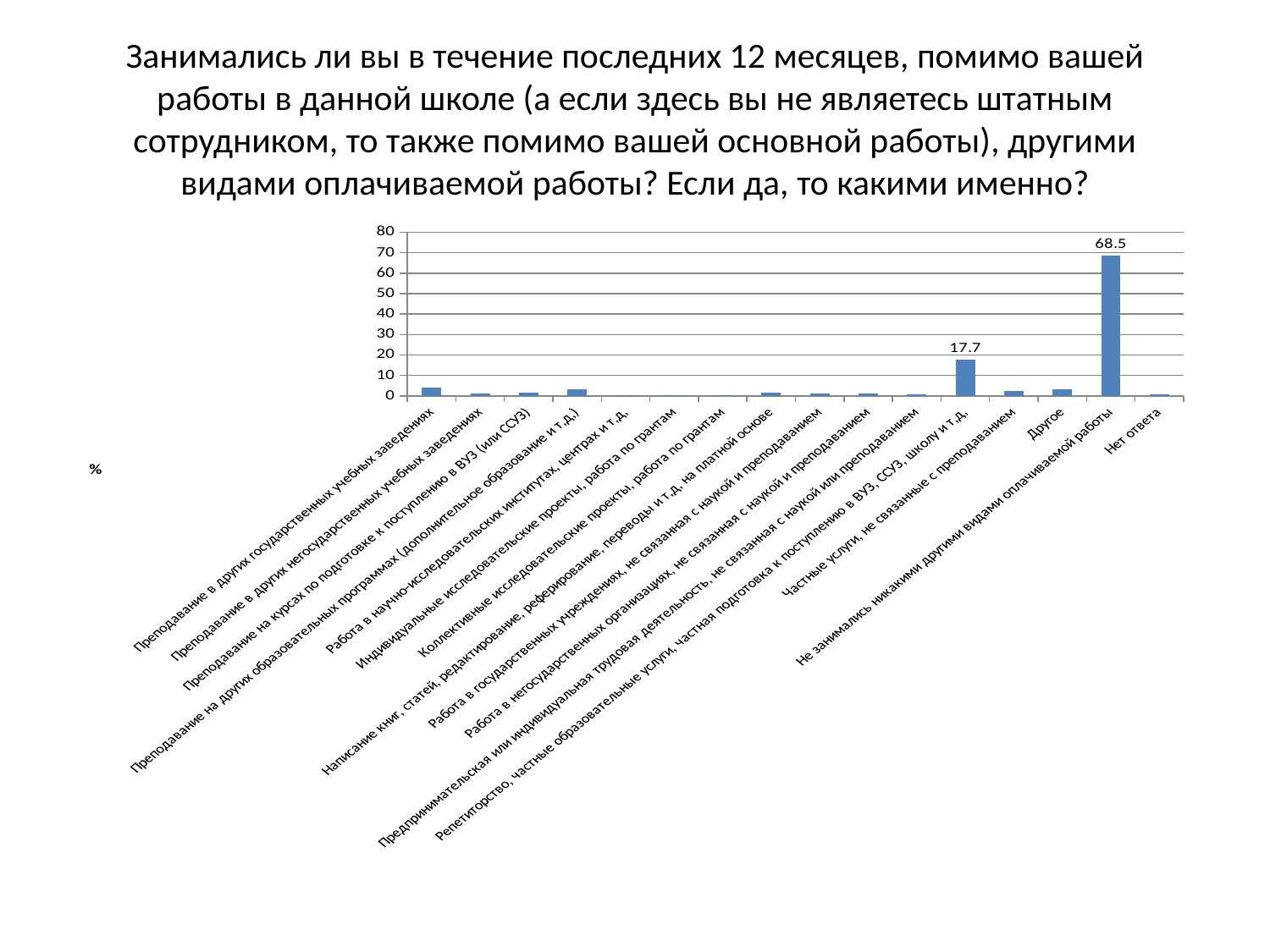
Which is larger: the value for "Репетиторство, частные образовательные услуги, частная подготовка к поступлению в ВУЗ, ССУЗ, школу и т.д." or the value for "Другое"? Репетиторство, частные образовательные услуги, частная подготовка к поступлению в ВУЗ, ССУЗ, школу и т.д. How many categories are shown on the x axis of the chart? 16 What kind of chart is shown on the slide? Bar chart Is the value for "Репетиторство, частные образовательные услуги, частная подготовка к поступлению в ВУЗ, ССУЗ, школу и т.д." greater or less than 20? less What value is shown for "Репетиторство, частные образовательные услуги, частная подготовка к поступлению в ВУЗ, ССУЗ, школу и т.д."? 17.7 Which category has the highest value? Не занимались никакими другими видами оплачиваемой работы What value is shown for "Не занимались никакими другими видами оплачиваемой работы"? 68.5 Is the value for "Не занимались никакими другими видами оплачиваемой работы" greater or less than 60? greater What is the highest value shown on the vertical axis of the chart? 80 Is the value for "Другое" greater or less than 10? less What is the difference between the value for "Не занимались никакими другими видами оплачиваемой работы" and the value for "Репетиторство, частные образовательные услуги, частная подготовка к поступлению в ВУЗ, ССУЗ, школу и т.д."? 50.8